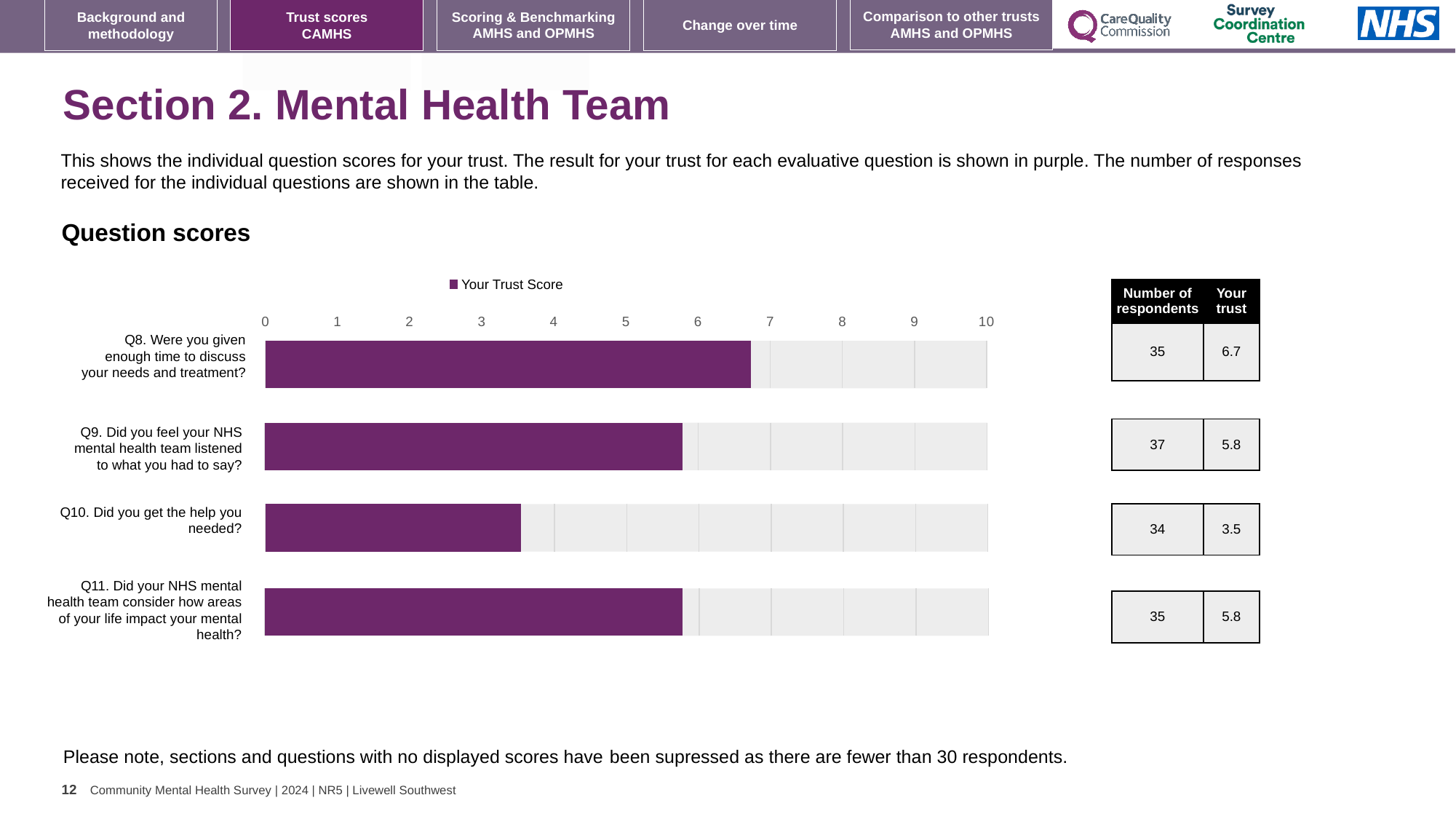
How many series does the legend list? 1 What is the name of the series shown in the legend? Your Trust Score Is the trust score for Q8 greater or less than 6? greater What is the trust score for Q10 (Did you get the help you needed?)? 3.5 What is the difference between the trust scores for Q8 and Q10? 3.2 What is the trust score for Q8 (Were you given enough time to discuss your needs and treatment?)? 6.7 Is the trust score for Q10 greater or less than 4? less How many questions are plotted in the chart? 4 Which question has the highest trust score? Q8 Which question has the lowest trust score? Q10 Which has the larger trust score, Q9 or Q10? Q9 What kind of chart is shown? bar chart